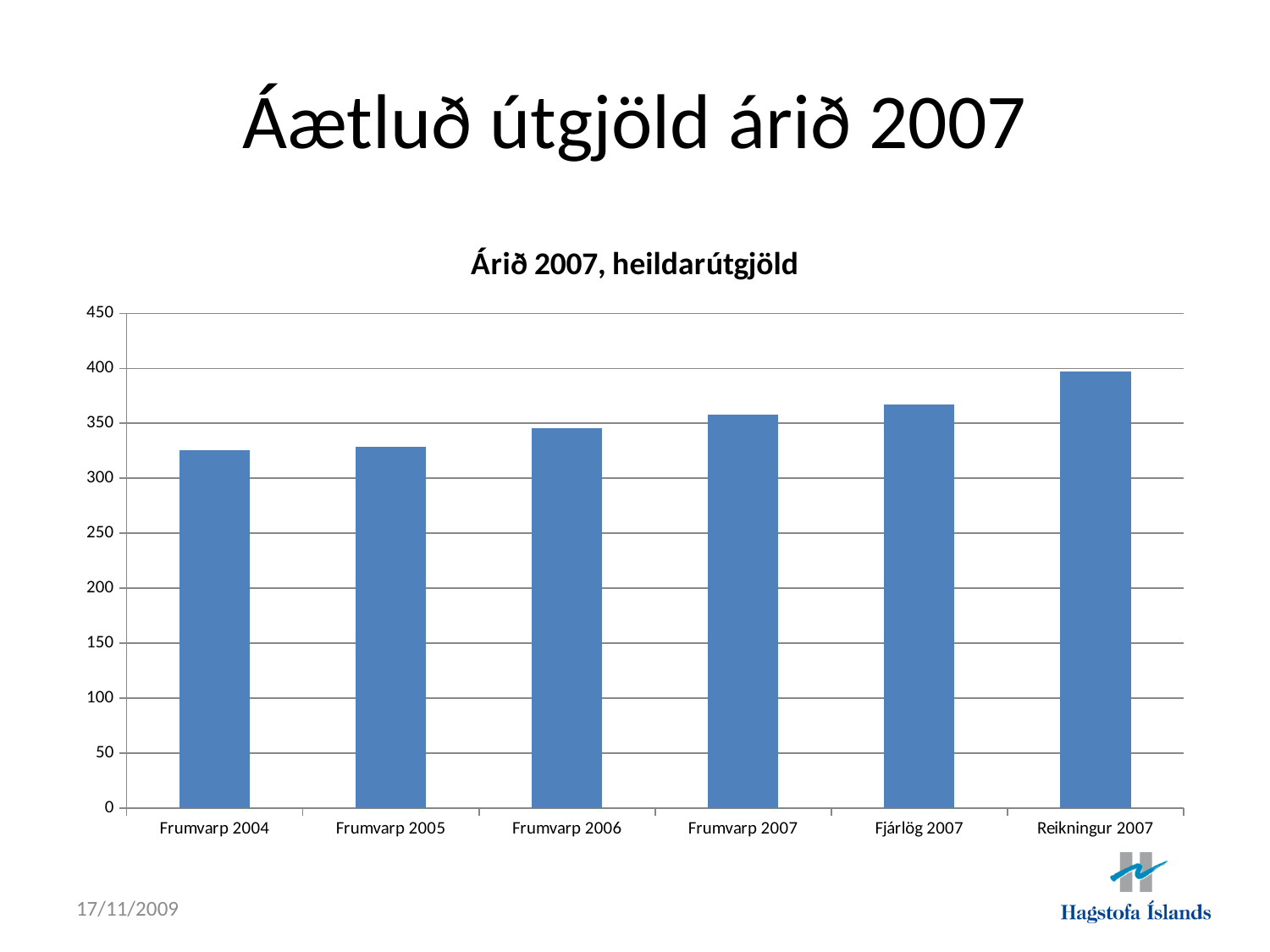
Is the value for Frumvarp 2005 greater or less than 350? less What is the title of the chart? Árið 2007, heildarútgjöld What kind of chart is shown on the slide? bar chart Is the value for Frumvarp 2004 greater or less than 300? greater Do the values rise or fall from left to right along the x axis? rise How many categories are shown on the x axis of the chart? 6 Which is larger, the value for Frumvarp 2006 or the value for Fjárlög 2007? Fjárlög 2007 Which category has the highest value in the chart? Reikningur 2007 What is the highest value shown on the vertical axis of the chart? 450 Is the value for Frumvarp 2007 greater or less than 350? greater Which is larger, the value for Reikningur 2007 or the value for Frumvarp 2004? Reikningur 2007